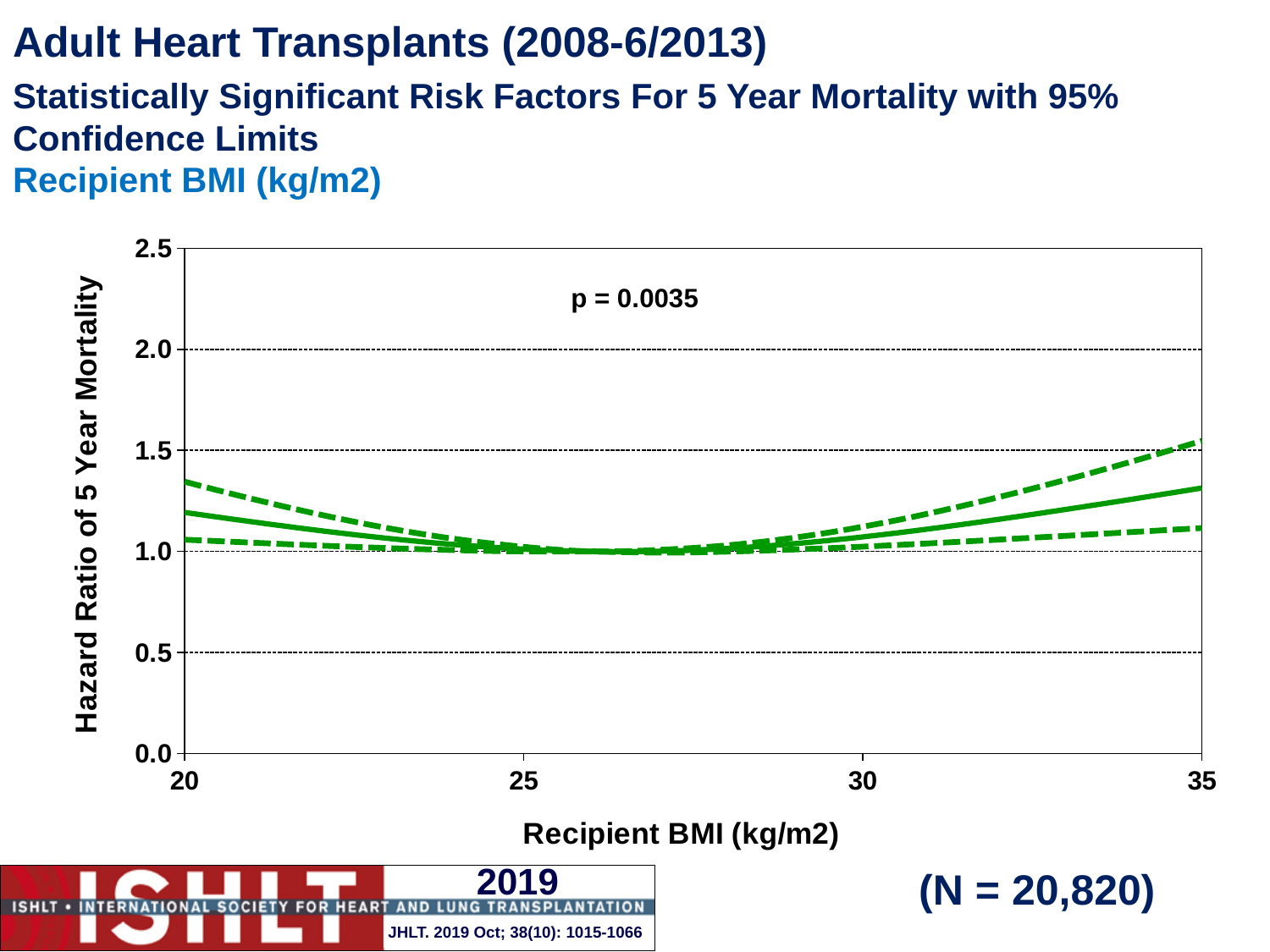
What is the label of the y axis? Hazard Ratio of 5 Year Mortality Is the hazard ratio of 5 year mortality at a recipient BMI of 30 greater or less than 1.5? less What p-value is printed on the chart? p = 0.0035 Is the hazard ratio of 5 year mortality at a recipient BMI of 20 greater or less than 1.5? less Is the upper confidence limit at a recipient BMI of 35 greater or less than 2.0? less How many lines are plotted on the chart? 3 Does the hazard ratio rise or fall as recipient BMI increases from 30 to 35? rise What kind of chart is shown on the slide? line chart Does the hazard ratio rise or fall as recipient BMI increases from 20 to 25? fall Is the hazard ratio at a recipient BMI of 35 higher or lower than at a recipient BMI of 20? higher